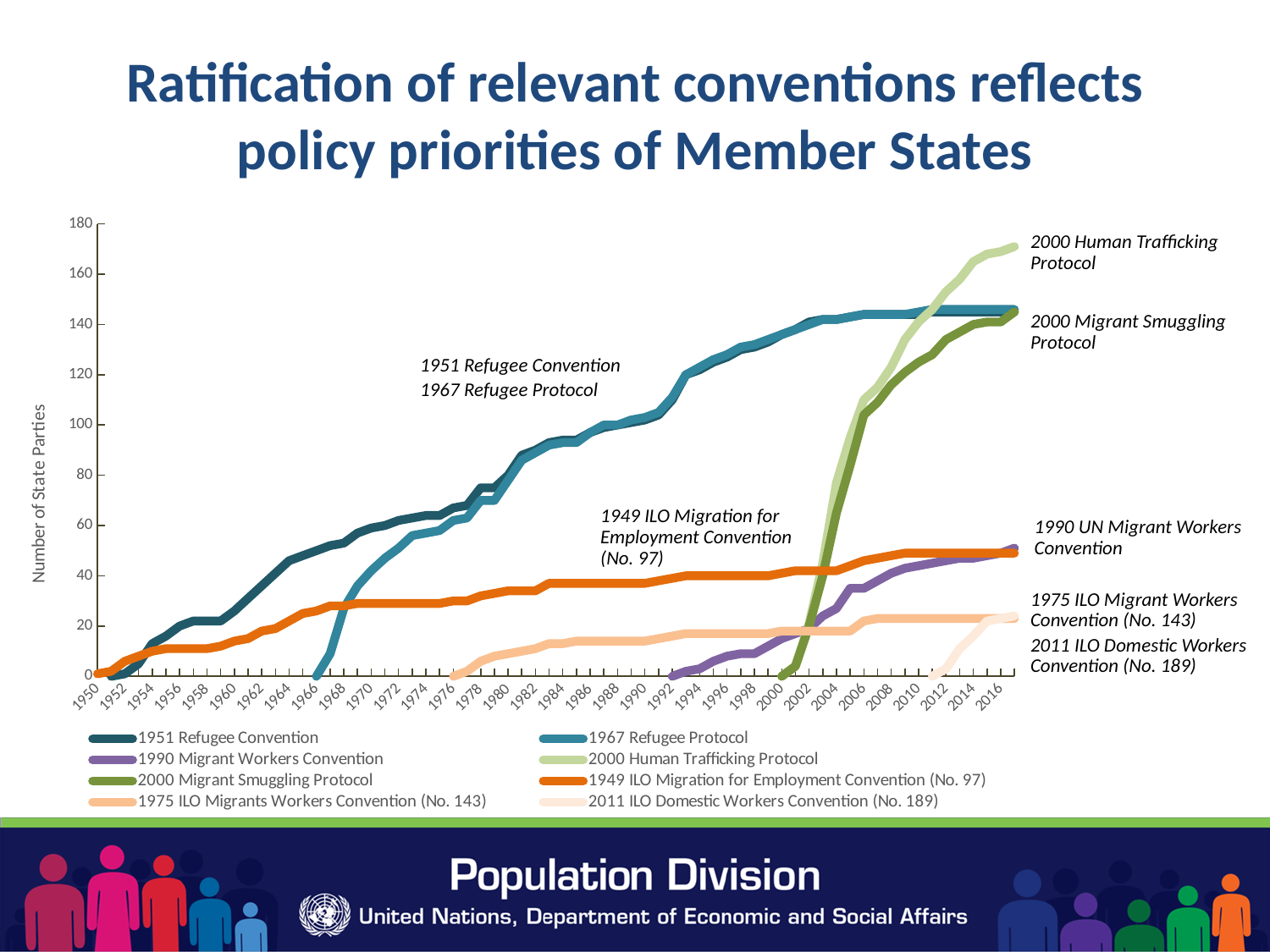
What kind of chart is shown on the slide? line chart Does the number of State Parties to the 1951 Refugee Convention rise or fall from 1950 to 2016? rise In 2016, which has more State Parties: the 2000 Human Trafficking Protocol or the 2000 Migrant Smuggling Protocol? 2000 Human Trafficking Protocol Is the value for the 1951 Refugee Convention in 2016 greater or less than 120? greater Is the value for the 1949 ILO Migration for Employment Convention (No. 97) in 2016 greater or less than 60? less Is the value for the 2000 Human Trafficking Protocol in 2016 greater or less than 160? greater What is the label of the y axis? Number of State Parties Which series begins latest on the x axis? 2011 ILO Domestic Workers Convention (No. 189) In 2016, which has more State Parties: the 1951 Refugee Convention or the 1990 Migrant Workers Convention? 1951 Refugee Convention Which series has the highest number of State Parties in 2016? 2000 Human Trafficking Protocol How many series does the legend list? 8